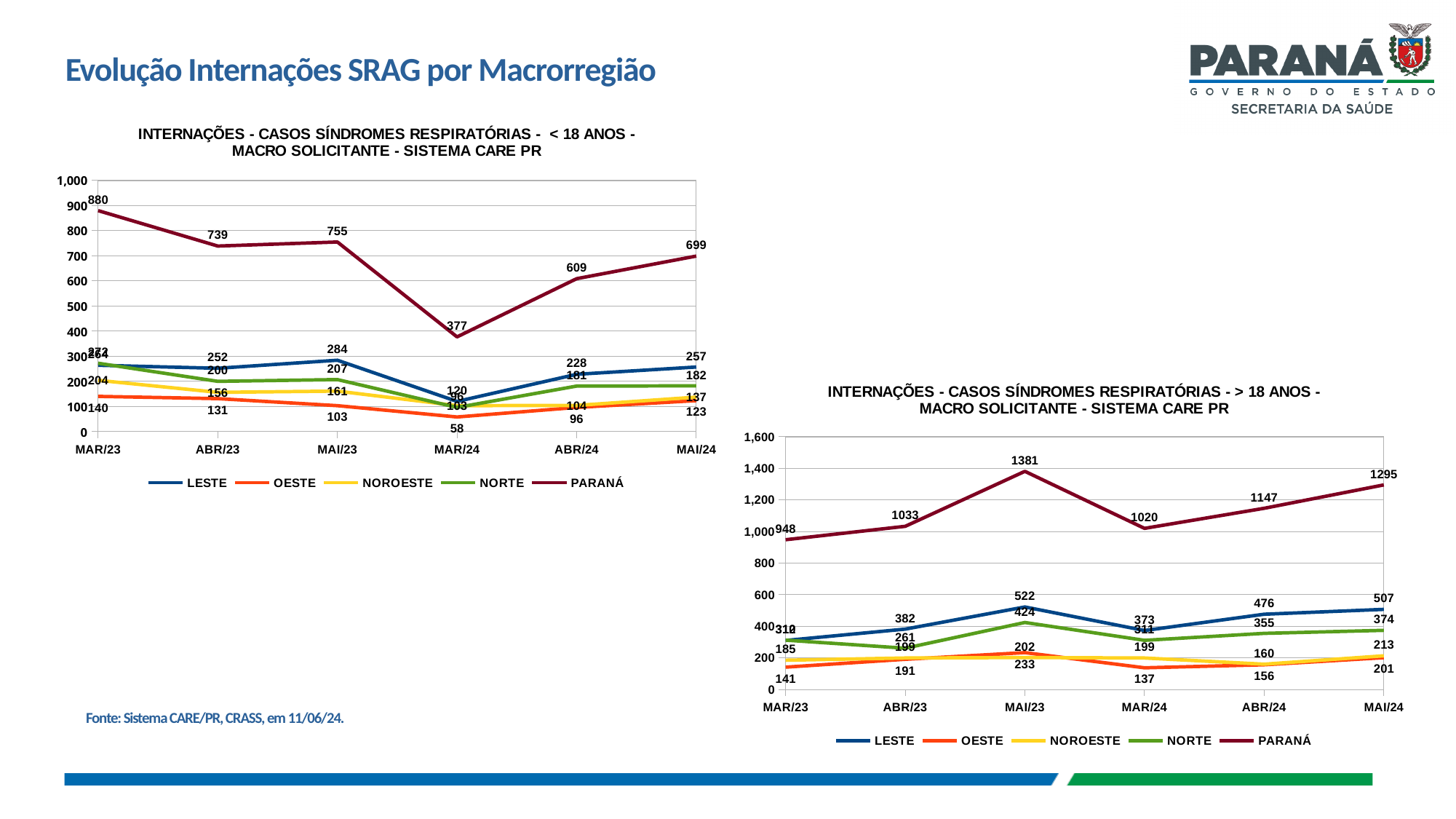
In the '> 18 ANOS' chart, what is the LESTE value for MAI/24? 507 In the '< 18 ANOS' chart, what is the OESTE value for ABR/24? 96 In the '< 18 ANOS' chart, what is the LESTE value for MAI/23? 284 In the '< 18 ANOS' chart, in which month is the PARANÁ series highest? MAR/23 In the '< 18 ANOS' chart, what is the PARANÁ value for MAR/24? 377 How many months are shown on the x axis of the '< 18 ANOS' chart? 6 What kind of chart is the '> 18 ANOS' chart? Line chart How many series does the legend of the '> 18 ANOS' chart list? 5 In the '> 18 ANOS' chart, what is the PARANÁ value for MAI/23? 1381 In the '> 18 ANOS' chart, which is larger, the NORTE value for MAI/23 or the NORTE value for ABR/24? MAI/23 In the '> 18 ANOS' chart, in which month is the PARANÁ series lowest? MAR/23 In the '< 18 ANOS' chart, what is the difference between the PARANÁ values for MAR/23 and ABR/23? 141